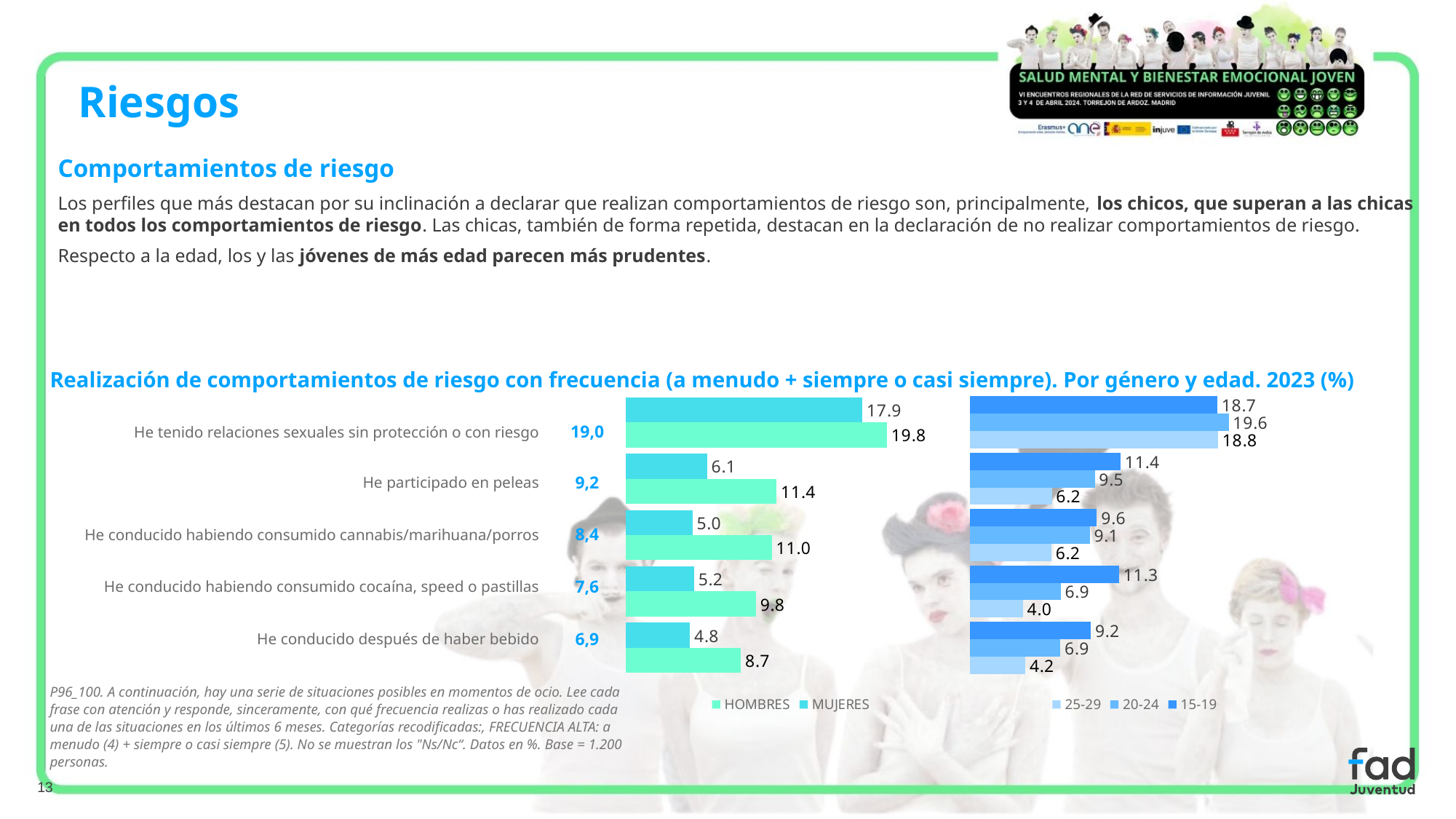
In the left chart (by gender), what is the value for HOMBRES for 'He participado en peleas'? 11.4 In the left chart (by gender), what is the value for MUJERES for 'He conducido después de haber bebido'? 4.8 In the right chart (by age), what is the value for the 25-29 group for 'He tenido relaciones sexuales sin protección o con riesgo'? 18.8 In the right chart (by age), what is the value for the 15-19 group for 'He conducido habiendo consumido cocaína, speed o pastillas'? 11.3 In the left chart (by gender), what is the difference between HOMBRES and MUJERES for 'He conducido habiendo consumido cannabis/marihuana/porros'? 6.0 In the right chart (by age), which is larger for 'He participado en peleas': the 15-19 group or the 25-29 group? 15-19 How many series does the legend of the right chart (by age) list? 3 In the right chart (by age), which category has the lowest value for the 25-29 group? He conducido habiendo consumido cocaína, speed o pastillas In the left chart (by gender), which category has the highest value for HOMBRES? He tenido relaciones sexuales sin protección o con riesgo What kind of chart is the left chart (by gender)? Bar chart How many categories are shown in the left chart (by gender)? 5 What is the total value shown in blue next to 'He conducido habiendo consumido cannabis/marihuana/porros'? 8,4